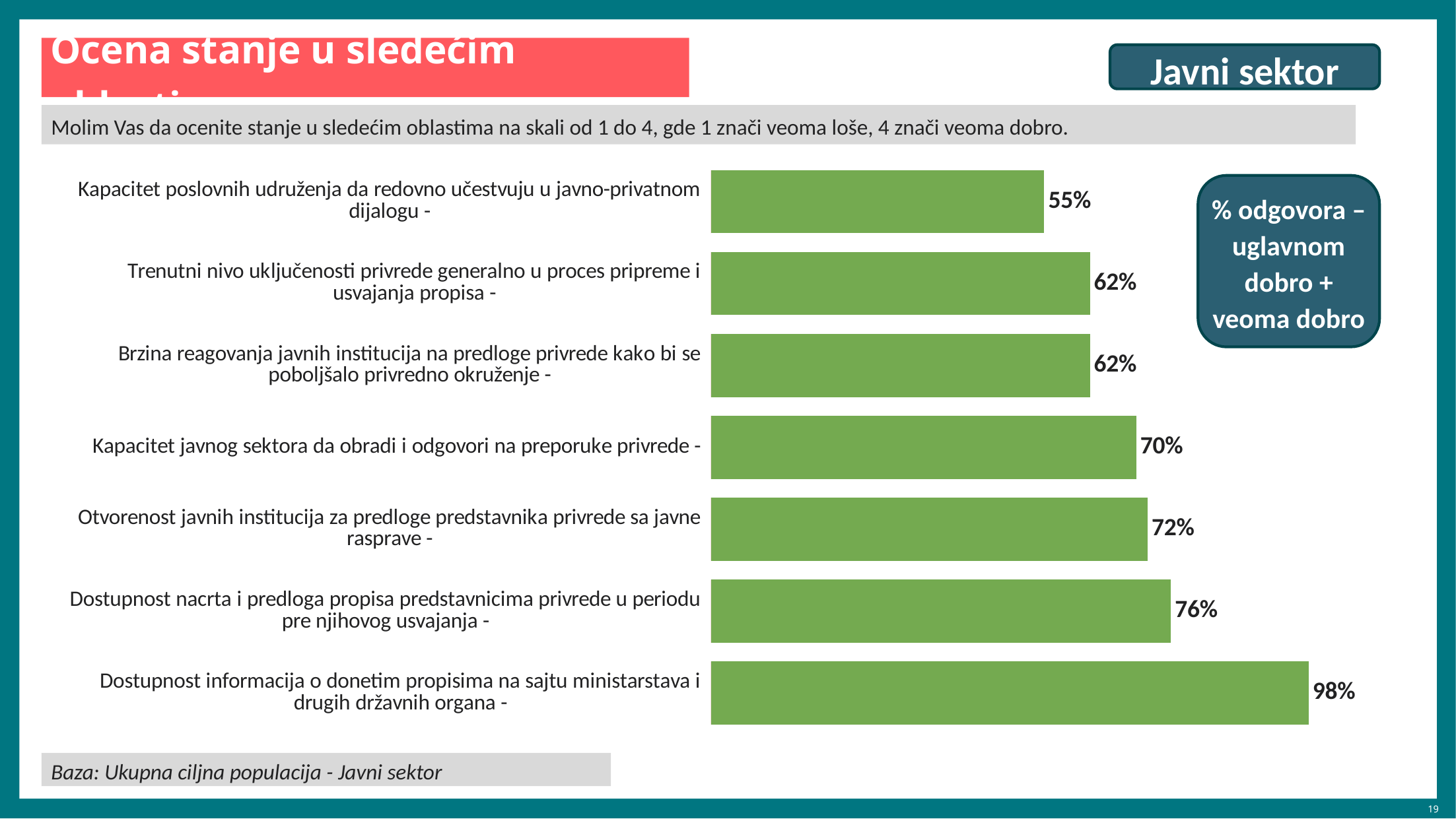
What is the value for "Kapacitet javnog sektora da obradi i odgovori na preporuke privrede"? 70% Which category has the highest value? Dostupnost informacija o donetim propisima na sajtu ministarstava i drugih državnih organa What is the difference between the values for "Trenutni nivo uključenosti privrede generalno u proces pripreme i usvajanja propisa" and "Kapacitet poslovnih udruženja da redovno učestvuju u javno-privatnom dijalogu"? 7% Which is larger: the value for "Otvorenost javnih institucija za predloge predstavnika privrede sa javne rasprave" or for "Kapacitet javnog sektora da obradi i odgovori na preporuke privrede"? Otvorenost javnih institucija za predloge predstavnika privrede sa javne rasprave What is the value for "Kapacitet poslovnih udruženja da redovno učestvuju u javno-privatnom dijalogu"? 55% What sector does the label in the top-right corner of the slide name? Javni sektor What is the value for "Otvorenost javnih institucija za predloge predstavnika privrede sa javne rasprave"? 72% What kind of chart is shown on the slide? Bar chart How many categories are shown in the chart? 7 What is the difference between the values for "Dostupnost informacija o donetim propisima na sajtu ministarstava i drugih državnih organa" and "Dostupnost nacrta i predloga propisa predstavnicima privrede u periodu pre njihovog usvajanja"? 22% What is the value for "Dostupnost informacija o donetim propisima na sajtu ministarstava i drugih državnih organa"? 98% Which category has the lowest value? Kapacitet poslovnih udruženja da redovno učestvuju u javno-privatnom dijalogu